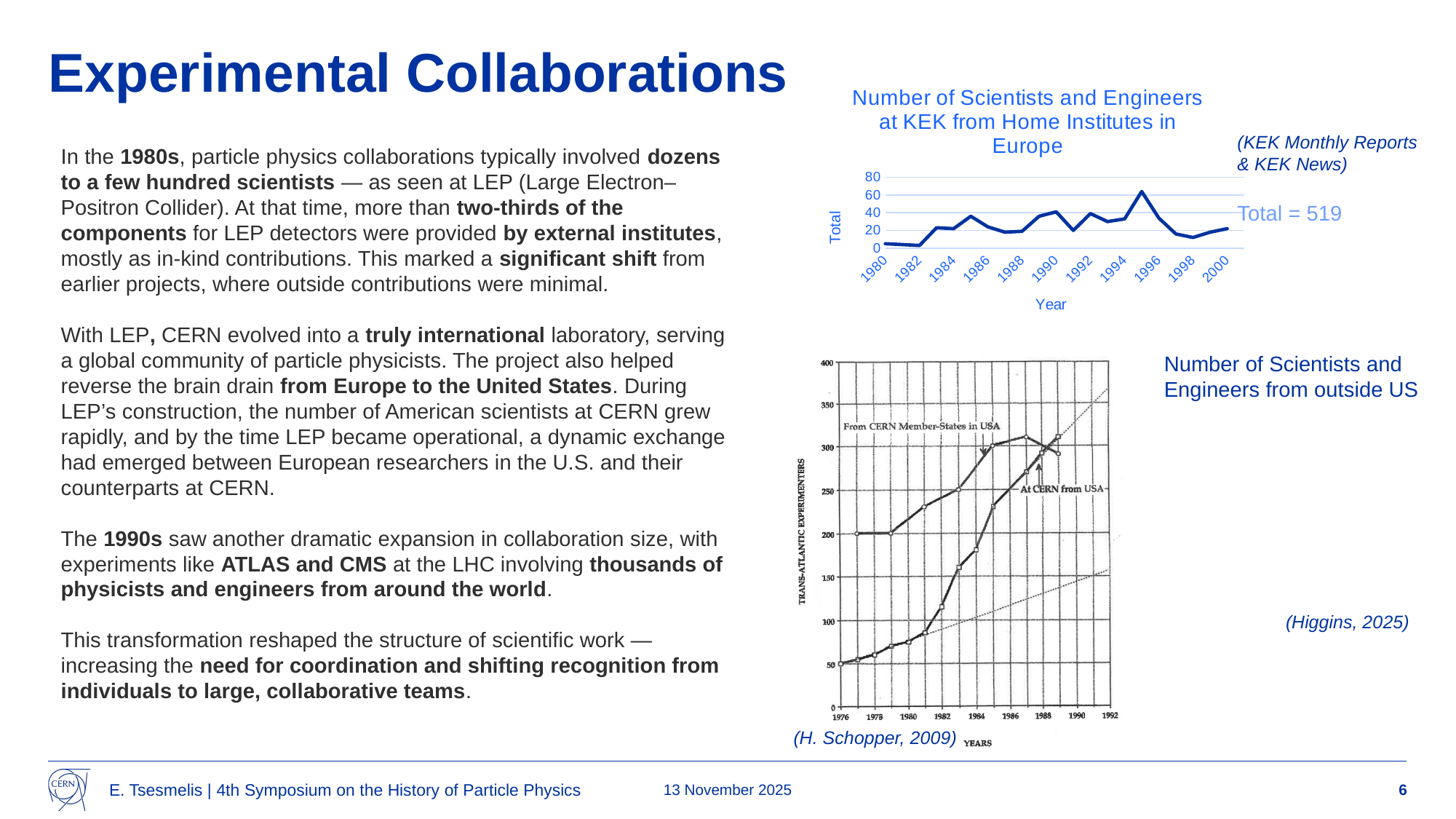
In the bottom chart (Number of Scientists and Engineers from outside US), which series is higher in 1980: 'From CERN Member-States in USA' or 'At CERN from USA'? From CERN Member-States in USA How many series are plotted in the bottom chart (Number of Scientists and Engineers from outside US)? 2 In the top chart (KEK from Home Institutes in Europe), is the value for 1998 greater or less than 40? less In the top chart (KEK from Home Institutes in Europe), is the value for 1980 greater or less than 20? less In the top chart (KEK from Home Institutes in Europe), does the value rise or fall between 1996 and 1998? fall What total is printed next to the top chart (KEK from Home Institutes in Europe)? Total = 519 In the bottom chart (Number of Scientists and Engineers from outside US), does the 'At CERN from USA' series rise or fall between 1980 and 1988? rise In the bottom chart (Number of Scientists and Engineers from outside US), is the 'At CERN from USA' value for 1976 greater or less than 100? less In the top chart (KEK from Home Institutes in Europe), which year has the highest value? 1995 What kind of chart is the top chart, 'Number of Scientists and Engineers at KEK from Home Institutes in Europe'? line chart What kind of chart is the bottom chart (Number of Scientists and Engineers from outside US)? line chart